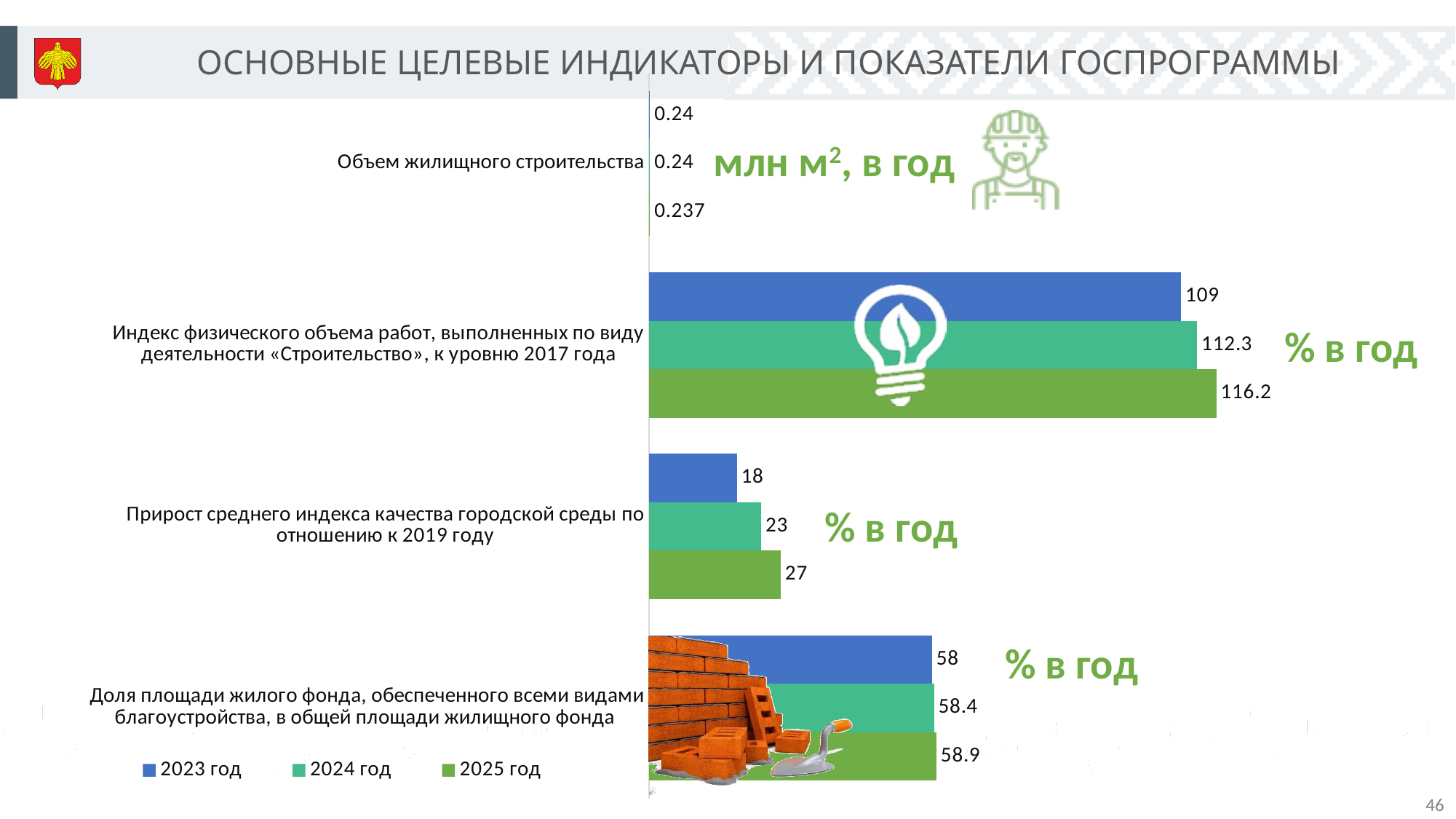
How many series does the legend list? 3 What type of chart is shown on the slide? bar chart What is the value for 2025 год for «Индекс физического объема работ, выполненных по виду деятельности «Строительство», к уровню 2017 года»? 116.2 How many categories are shown on the chart? 4 What is the value for 2023 год for «Прирост среднего индекса качества городской среды по отношению к 2019 году»? 18 What is the value for 2025 год for «Объем жилищного строительства»? 0.237 Which year has the highest value for «Прирост среднего индекса качества городской среды по отношению к 2019 году»? 2025 год Which is larger for «Индекс физического объема работ, выполненных по виду деятельности «Строительство», к уровню 2017 года»: the 2024 год value or the 2023 год value? 2024 год Which year has the lowest value for «Индекс физического объема работ, выполненных по виду деятельности «Строительство», к уровню 2017 года»? 2023 год What is the value for 2024 год for «Доля площади жилого фонда, обеспеченного всеми видами благоустройства, в общей площади жилищного фонда»? 58.4 What is the difference between the 2025 год and 2023 год values for «Прирост среднего индекса качества городской среды по отношению к 2019 году»? 9 Which colour represents 2024 год in the legend? teal (green-blue)